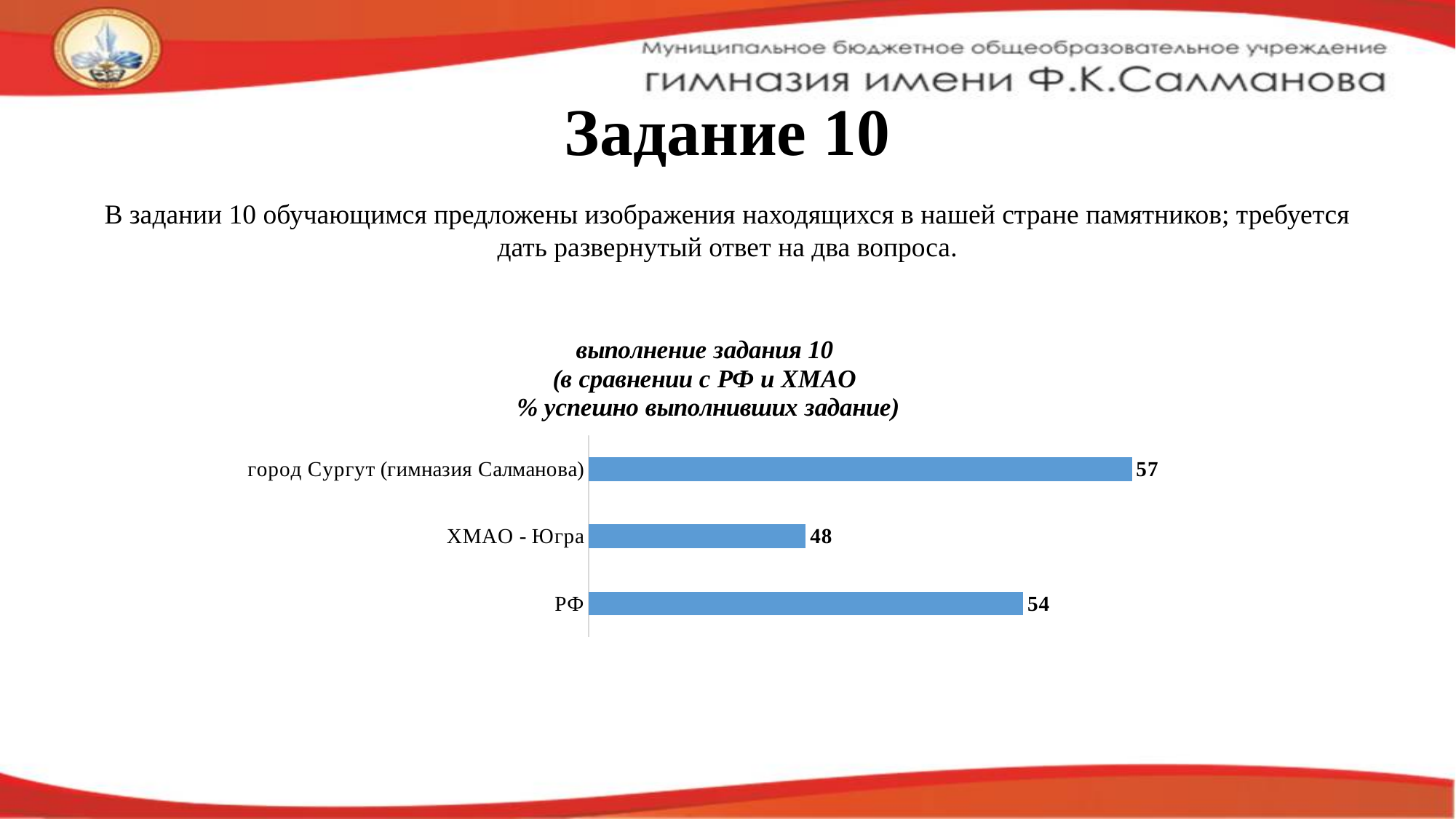
Which is larger, the value for РФ or the value for ХМАО - Югра? РФ What colour are the bars in the chart? blue How many categories are shown in the chart? 3 What is the value for город Сургут (гимназия Салманова)? 57 What is the difference between the values for город Сургут (гимназия Салманова) and РФ? 3 What is the value for ХМАО - Югра? 48 What is the value for РФ? 54 What is the difference between the values for РФ and ХМАО - Югра? 6 What kind of chart is shown on the slide? bar chart What is the title of the chart? выполнение задания 10 (в сравнении с РФ и ХМАО % успешно выполнивших задание) Which category has the lowest value? ХМАО - Югра Which category has the highest value? город Сургут (гимназия Салманова)